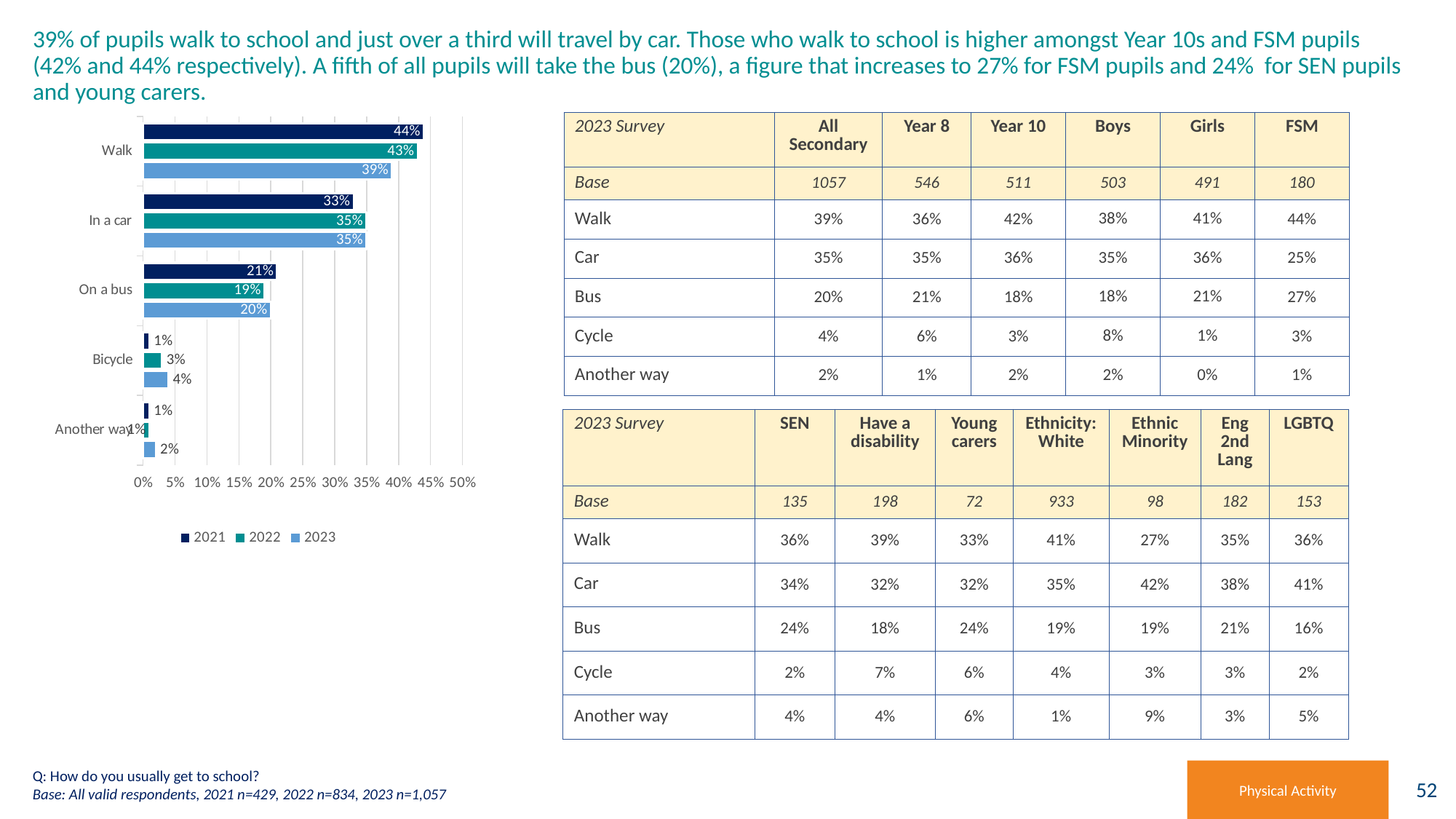
How many series does the chart's legend list? 3 What is the difference between the 2021 and 2023 values for Walk in the chart? 5% How many categories are shown on the chart? 5 Which series is shown in the darkest blue colour in the chart? 2021 What is the 2023 value for Walk in the chart? 39% What is the 2022 value for On a bus in the chart? 19% What is the 2021 value for In a car in the chart? 33% Which category has the lowest 2023 value in the chart? Another way What kind of chart is shown on the slide? bar chart Which is larger in the chart: the 2021 value for On a bus or the 2022 value for On a bus? 2021 Which category has the highest 2021 value in the chart? Walk What is the 2023 value for Bicycle in the chart? 4%